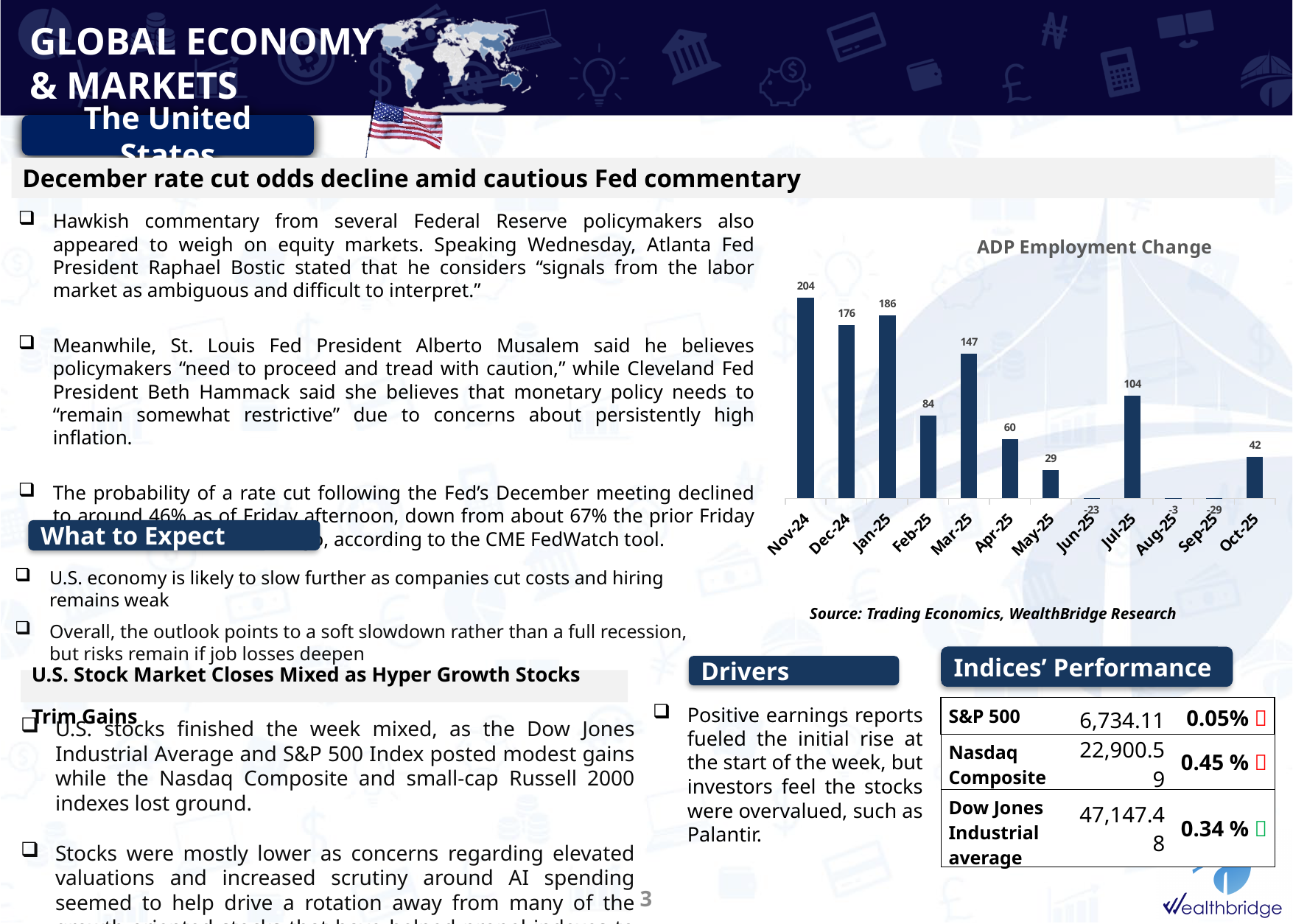
What is the ADP Employment Change value for Nov-24? 204 What is the ADP Employment Change value for Jul-25? 104 Which month has the lowest ADP Employment Change? Sep-25 Which month has the highest ADP Employment Change? Nov-24 What is the ADP Employment Change value for Sep-25? -29 What is the title of the chart on the slide? ADP Employment Change What is the ADP Employment Change value for Oct-25? 42 What is the difference between the ADP Employment Change for Jan-25 and Feb-25? 102 How many months in the ADP Employment Change chart have negative values? 3 How many months are shown in the ADP Employment Change chart? 12 Which is larger, the ADP Employment Change for Mar-25 or Apr-25? Mar-25 What type of chart is used to show ADP Employment Change? Bar chart